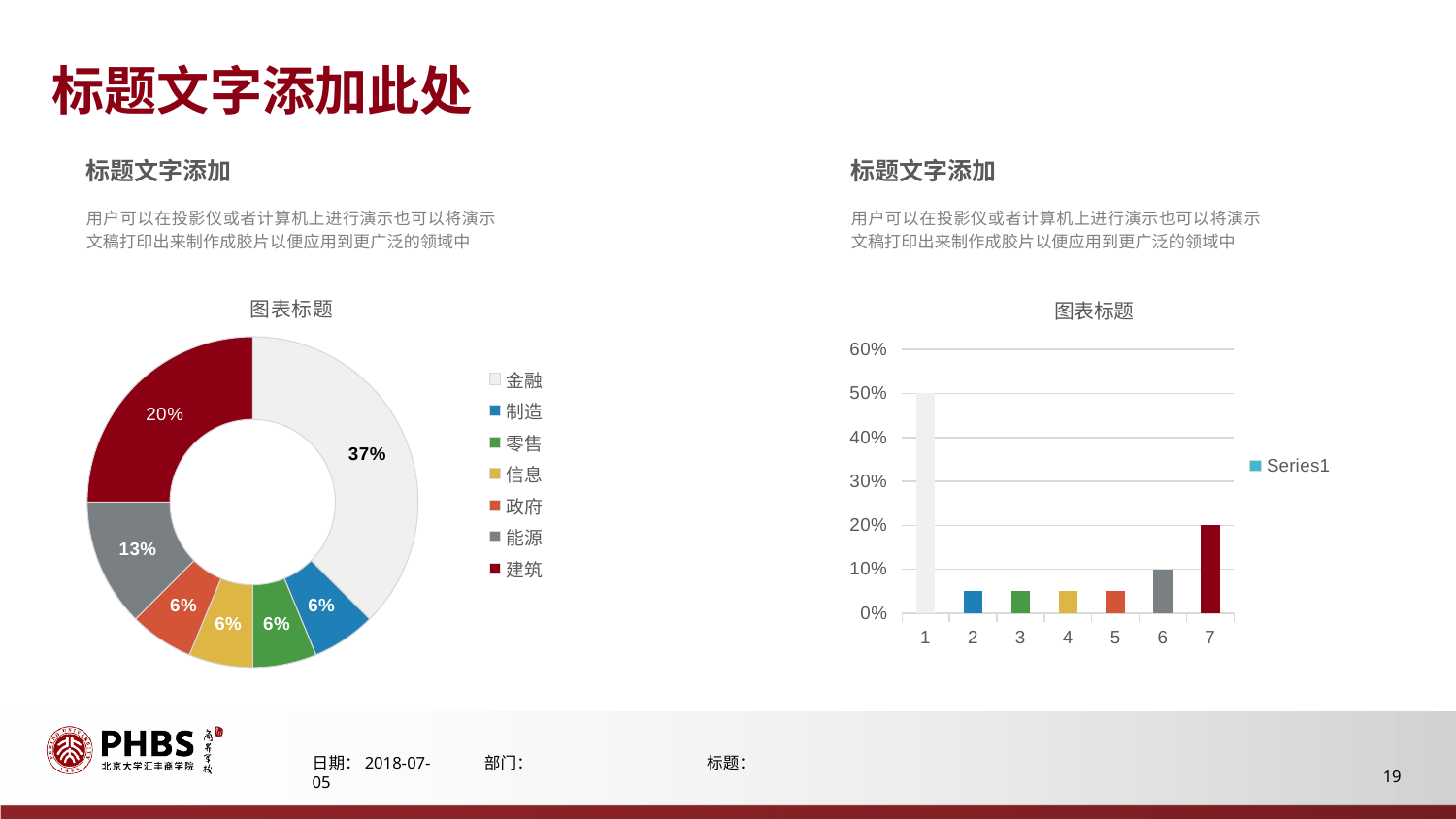
On the left chart, what is the difference between the shares of 金融 and 建筑? 17% On the right chart, what is the value for category 1? 50% What kind of chart is the left chart? Doughnut chart On the right chart, how many series does the legend list? 1 On the right chart, is the value for category 2 greater or less than 10%? less On the left chart, what share does 金融 have? 37% On the left chart, which category has the largest share? 金融 On the left chart, how many categories does the legend list? 7 On the right chart, what is the value for category 7? 20% On the left chart, what share does 能源 have? 13% On the left chart, what share does 建筑 have? 20% On the left chart, which is larger, the share of 能源 or the share of 建筑? 建筑